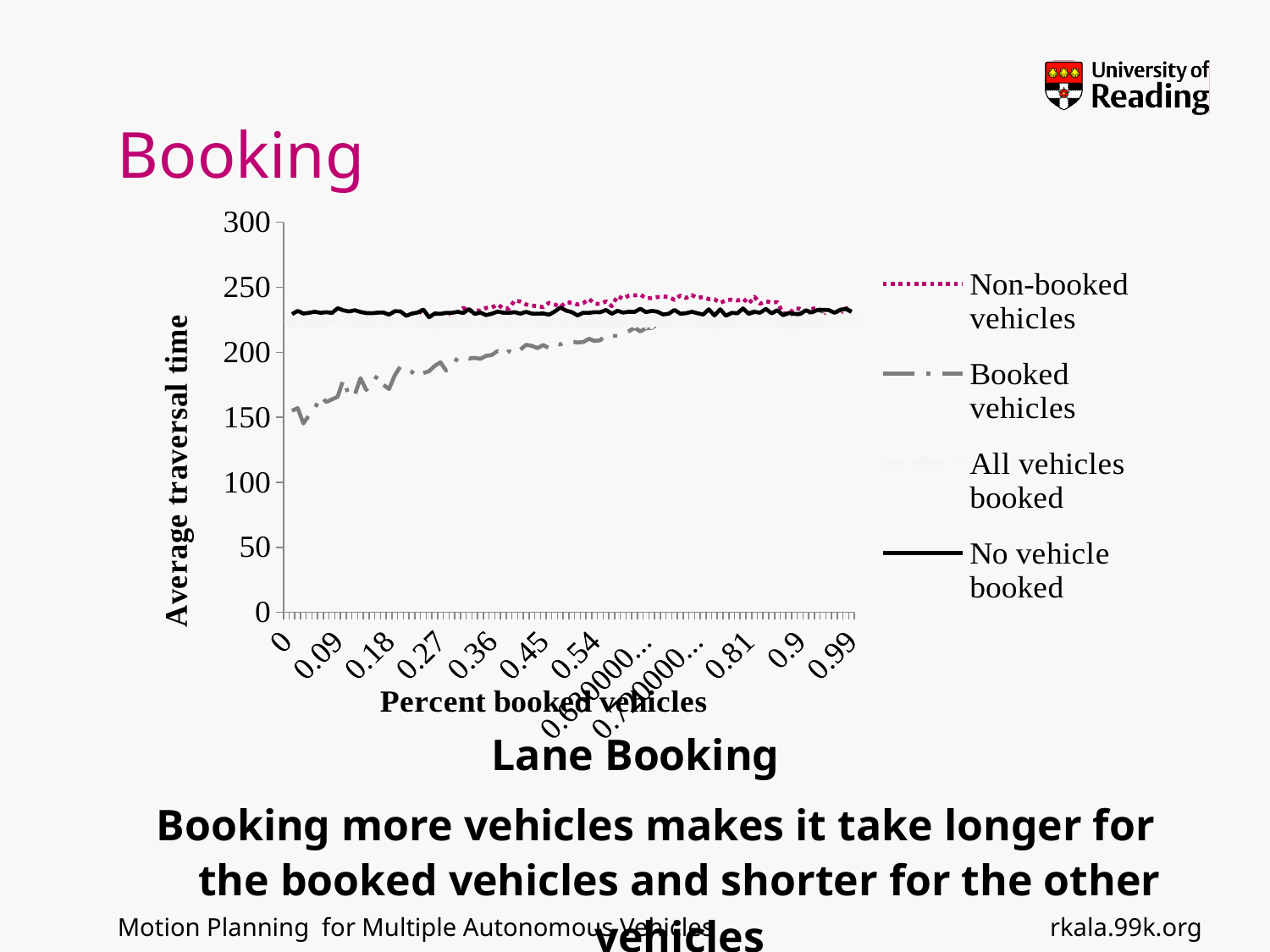
What kind of chart is shown on the slide? line chart How many series does the legend list? 4 What is the label of the vertical axis? Average traversal time At 0.18 percent booked vehicles, which is larger: the value for Non-booked vehicles or the value for Booked vehicles? Non-booked vehicles Which series has the lowest value at 0 percent booked vehicles? Booked vehicles Is the value for Booked vehicles at 0 percent booked vehicles greater or less than 100? greater Is the value for Booked vehicles at 0 percent booked vehicles greater or less than 200? less Does the Booked vehicles line rise or fall as the percent of booked vehicles increases? rise Is the value for Non-booked vehicles at 0.54 percent booked vehicles greater or less than 250? less At 0.09 percent booked vehicles, which is larger: the value for Booked vehicles or the value for No vehicle booked? No vehicle booked What is the title of the chart? Lane Booking